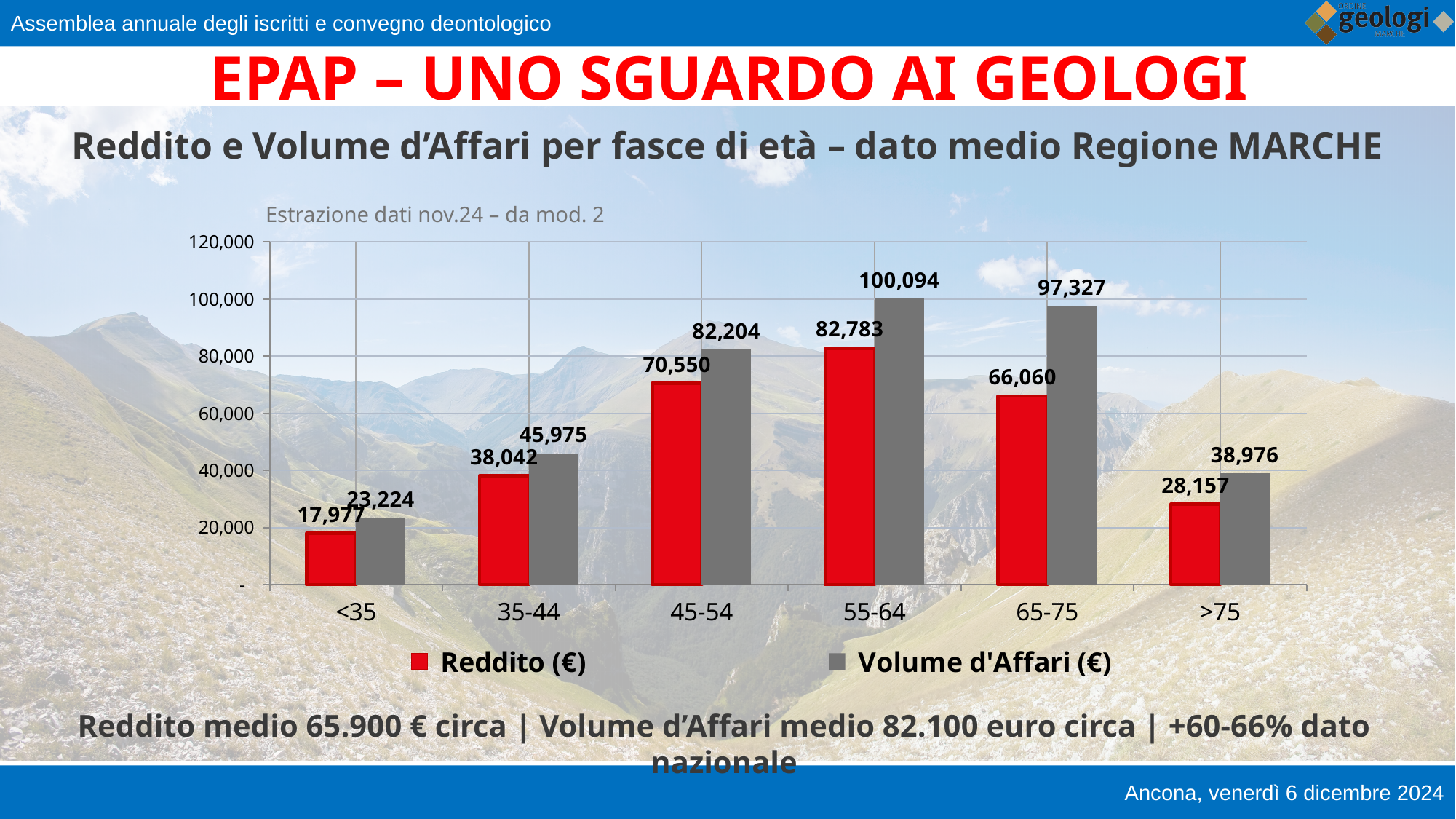
What is the difference between Volume d'Affari (€) and Reddito (€) for the 65-75 age group? 31,267 What is the difference between Volume d'Affari (€) and Reddito (€) for the 55-64 age group? 17,311 What is the Reddito (€) value for the <35 age group? 17,977 Which age group has the lowest Reddito (€)? <35 Which is larger: the Reddito (€) for 45-54 or the Reddito (€) for 65-75? 45-54 How many age groups are shown on the x axis? 6 What is the Reddito (€) value for the 55-64 age group? 82,783 Is the Volume d'Affari (€) for the 35-44 age group greater or less than 40,000? greater How many series does the legend list? 2 What type of chart is shown on the slide? Bar chart Which age group has the highest Volume d'Affari (€)? 55-64 What is the Volume d'Affari (€) value for the >75 age group? 38,976